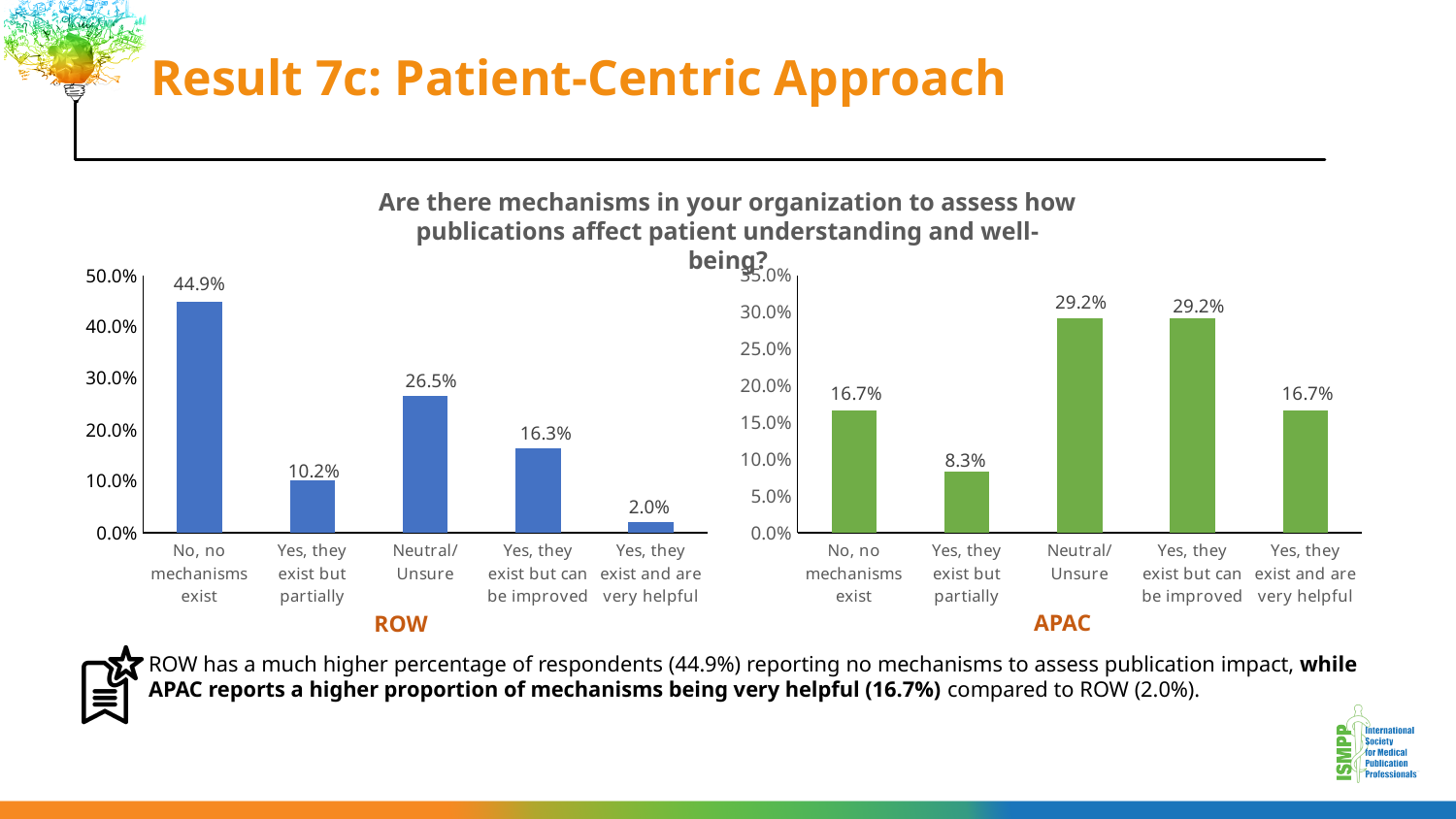
In the APAC chart, which category has the lowest value? Yes, they exist but partially How many categories are shown on the x axis of the APAC chart? 5 In the ROW chart, what is the value for 'Yes, they exist and are very helpful'? 2.0% In the ROW chart, what is the difference between 'Neutral/Unsure' and 'Yes, they exist but can be improved'? 10.2% What type of chart is used for the ROW data? Bar chart Which is larger: the APAC value for 'Yes, they exist and are very helpful' or the ROW value for the same category? APAC In the APAC chart, what percentage of respondents answered 'Yes, they exist but partially'? 8.3% In the ROW chart, what percentage of respondents said no mechanisms exist? 44.9% In the ROW chart, which category has the highest value? No, no mechanisms exist What is the difference between the ROW and APAC values for 'No, no mechanisms exist'? 28.2% In the ROW chart, which category has the lowest value? Yes, they exist and are very helpful In the APAC chart, what is the value for 'Neutral/Unsure'? 29.2%